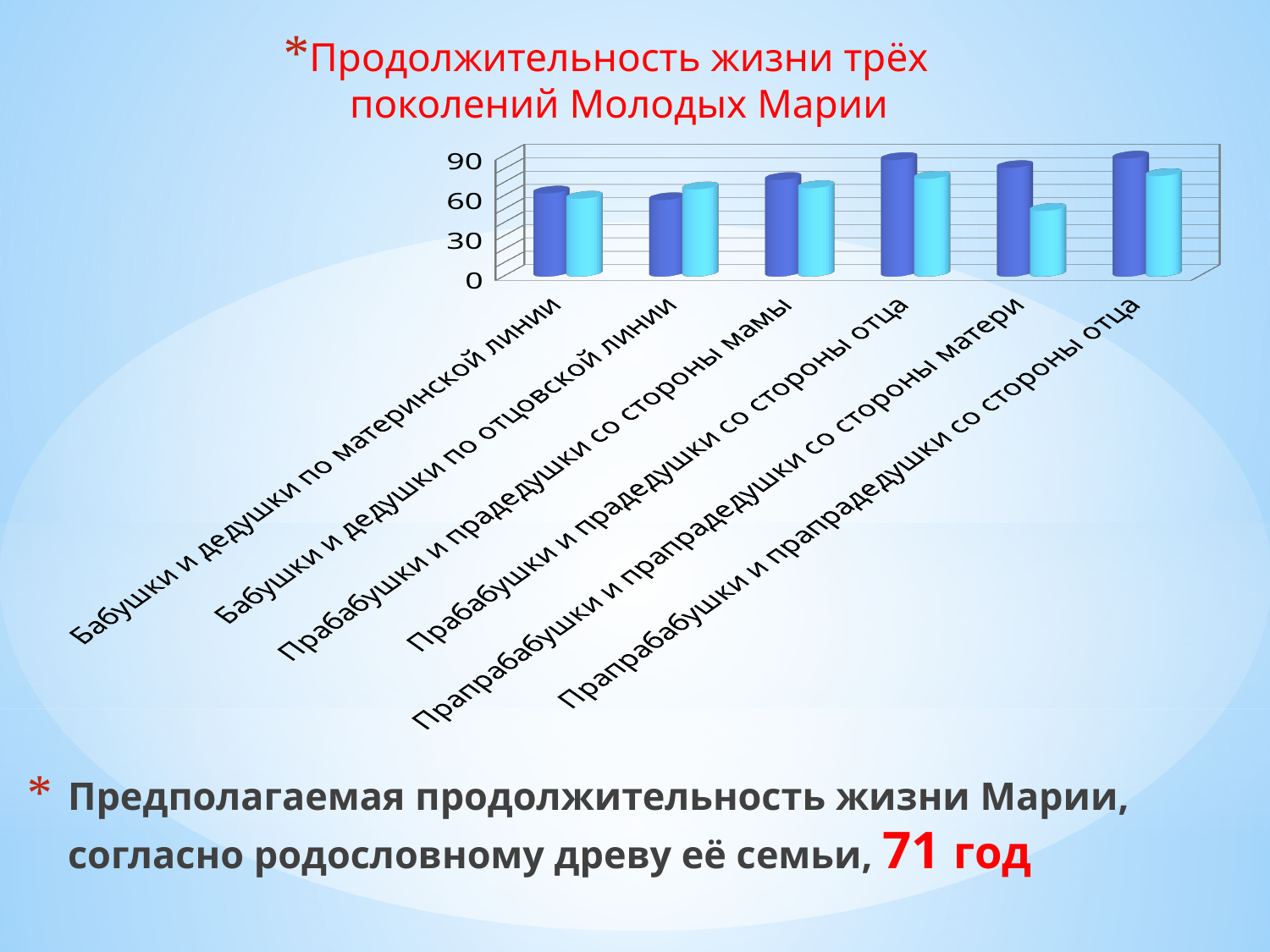
Is the light blue bar for 'Прапрабабушки и прапрадедушки со стороны отца' greater or less than 60? greater For 'Бабушки и дедушки по отцовской линии', which bar is taller, the dark blue or the light blue one? light blue Is the dark blue bar for 'Прабабушки и прадедушки со стороны мамы' greater or less than 60? greater Is the light blue bar for 'Прапрабабушки и прапрадедушки со стороны матери' greater or less than 60? less What kind of chart is shown on the slide? Bar chart Which category has the lowest light blue bar? Прапрабабушки и прапрадедушки со стороны матери How many categories are shown on the x axis of the chart? 6 What is the title of the chart on the slide? Продолжительность жизни трёх поколений Молодых Марии For 'Прапрабабушки и прапрадедушки со стороны матери', which bar is taller, the dark blue or the light blue one? dark blue How many bars (series) are plotted for each category in the chart? 2